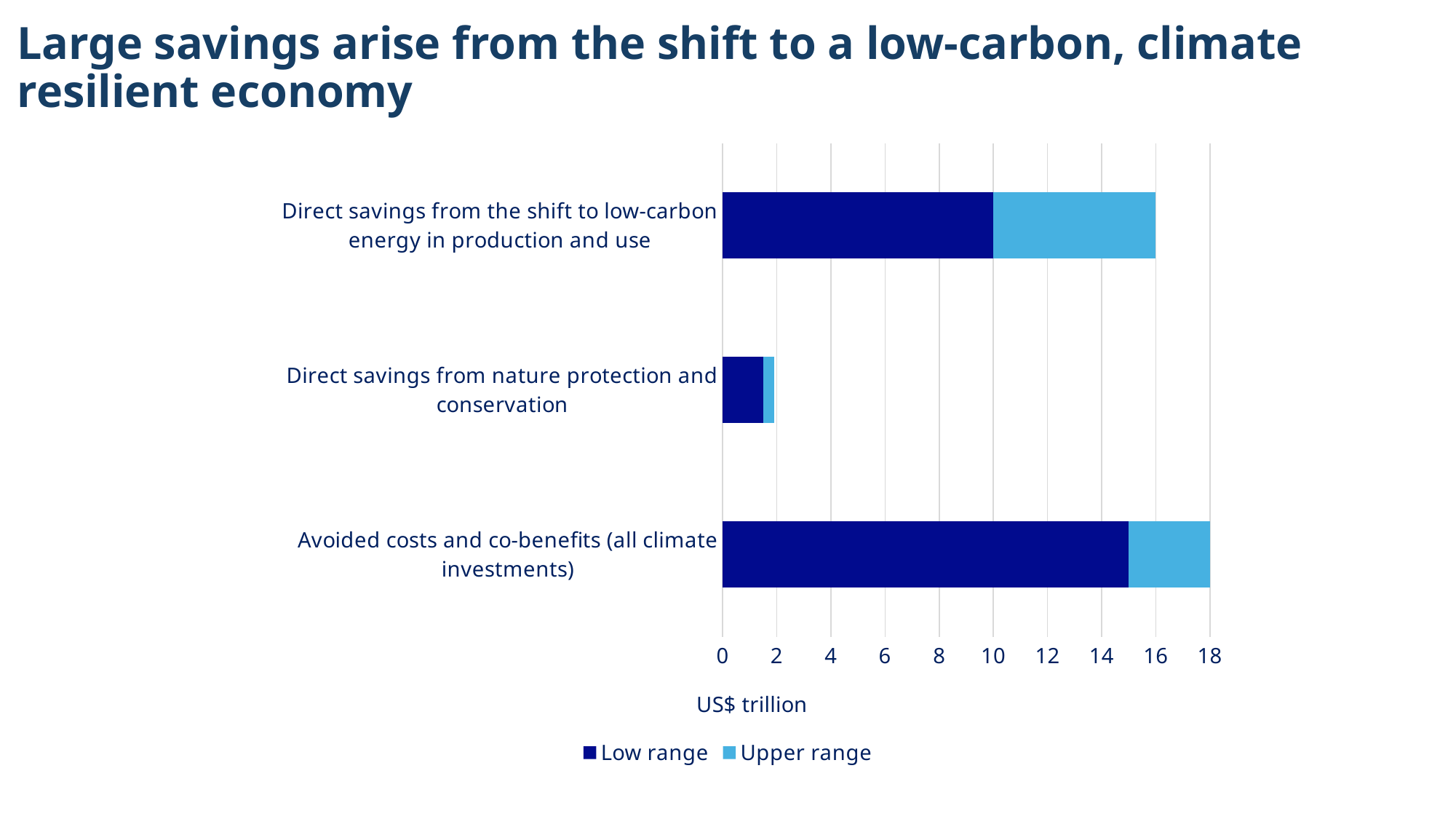
What is the Low range value for 'Direct savings from the shift to low-carbon energy in production and use'? 10 Is the total bar for 'Direct savings from nature protection and conservation' greater or less than 4? less How many series does the legend list? 2 Which is larger: the Low range value for 'Avoided costs and co-benefits (all climate investments)' or the Low range value for 'Direct savings from the shift to low-carbon energy in production and use'? Avoided costs and co-benefits (all climate investments) What unit is shown on the horizontal axis? US$ trillion What is the total length of the stacked bar for 'Direct savings from the shift to low-carbon energy in production and use'? 16 What kind of chart is shown on the slide? bar chart Which category has the longest total bar? Avoided costs and co-benefits (all climate investments) Which category has the shortest total bar? Direct savings from nature protection and conservation What is the total length of the stacked bar for 'Avoided costs and co-benefits (all climate investments)'? 18 Is the Low range value for 'Avoided costs and co-benefits (all climate investments)' greater or less than 14? greater How many categories are plotted in the chart? 3